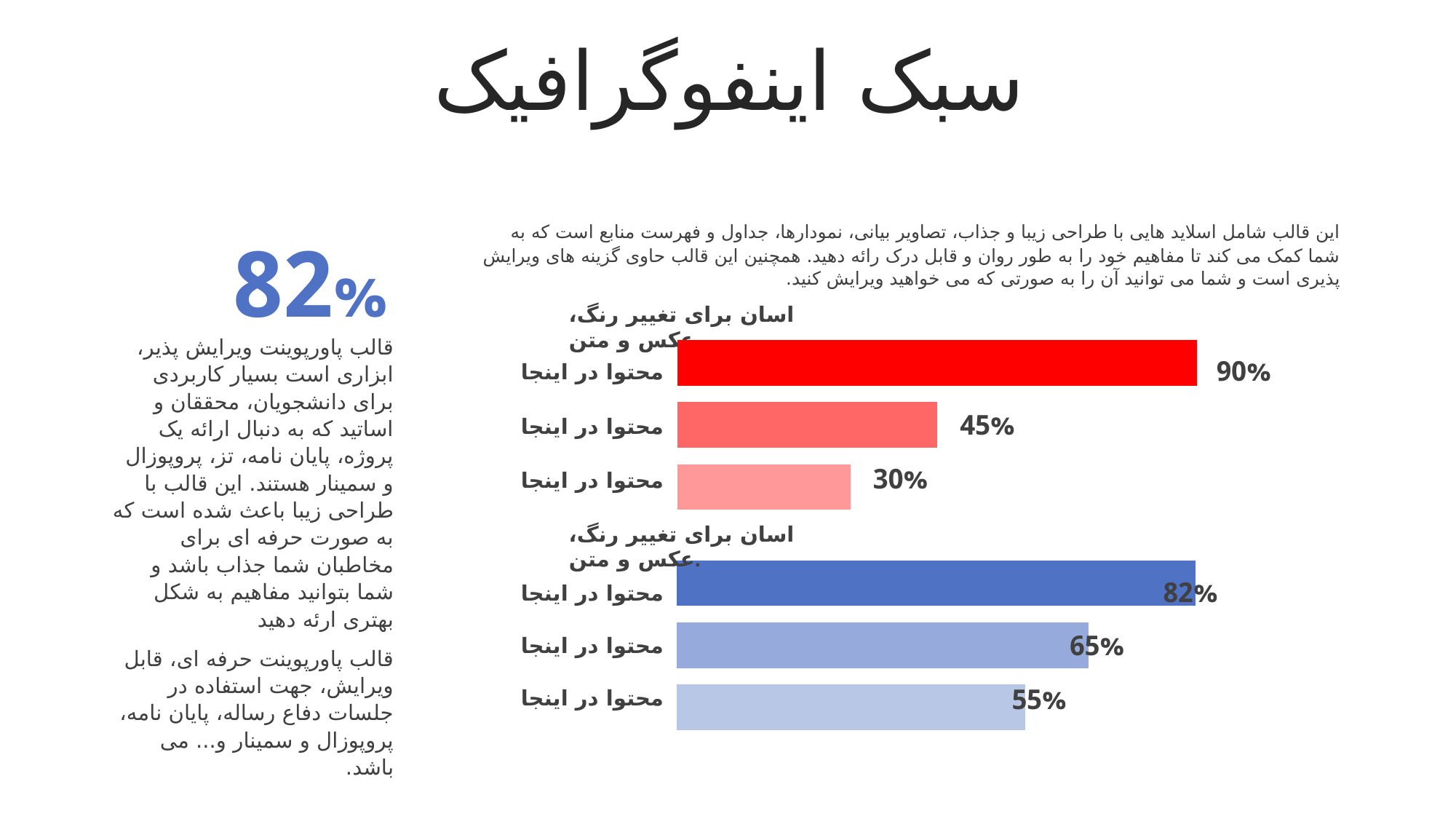
In the upper red bar chart, which bar has the highest value? The top bar (90%) In the upper red bar chart, what is the difference between the top bar and the middle bar? 45% In the lower blue bar chart, what is the value of the middle bar? 65% In the lower blue bar chart, what is the value of the bottom bar? 55% In the upper red bar chart, what is the value of the bottom bar? 30% How many bars does the upper red chart contain? 3 In the lower blue bar chart, what is the difference between the top bar and the bottom bar? 27% In the upper red bar chart, what is the value of the top bar? 90% What colour are the bars in the lower chart? Blue What type of chart is used on this slide? Bar chart In the lower blue bar chart, which bar has the lowest value? The bottom bar (55%) Which is larger: the top bar of the red chart or the top bar of the blue chart? The top bar of the red chart (90%)